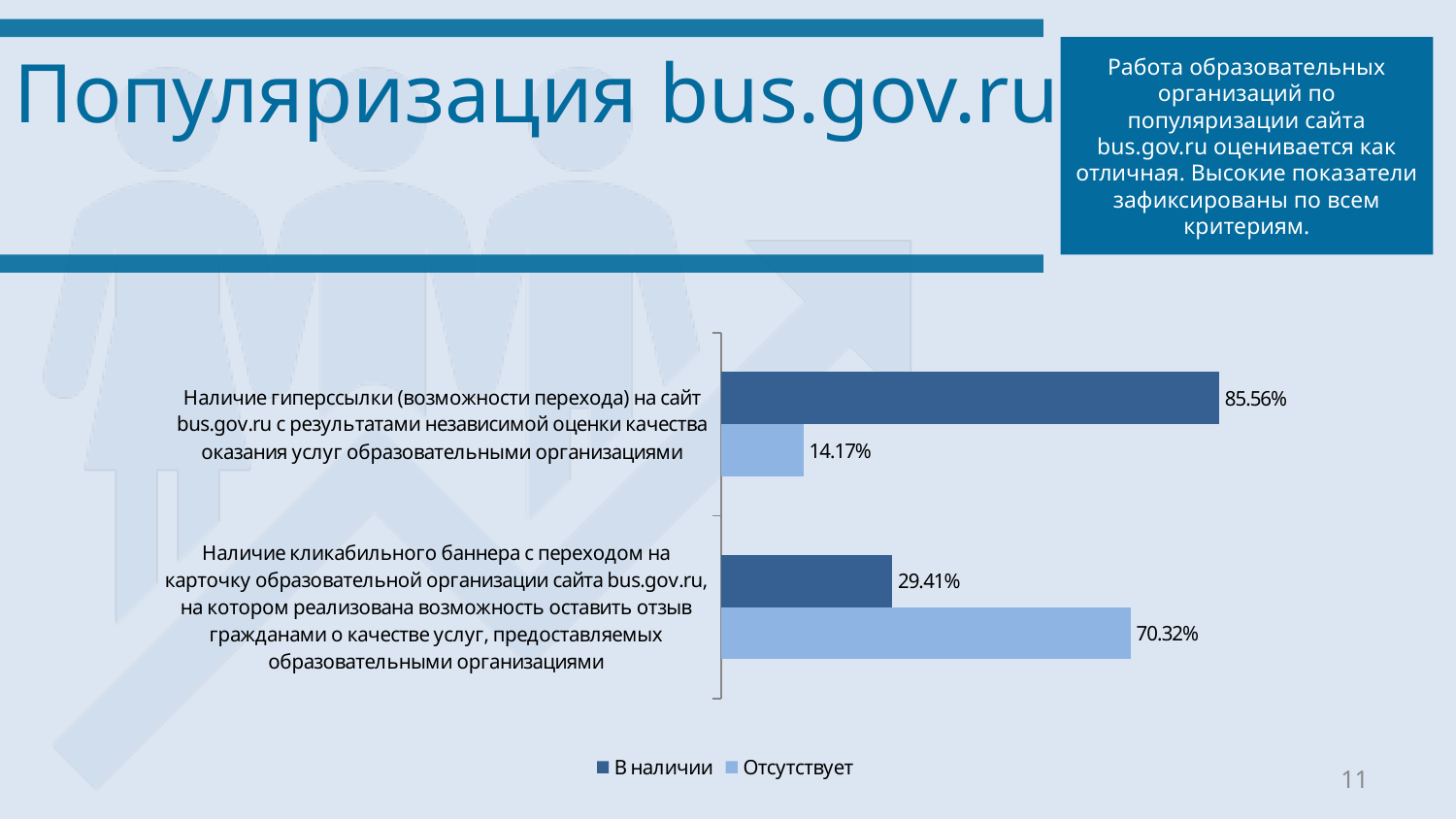
What is the value of "Отсутствует" for the category about the clickable banner (Наличие кликабильного баннера)? 70.32% What kind of chart is shown on the slide? bar chart What is the value of "Отсутствует" for the category about the hyperlink to bus.gov.ru (Наличие гиперссылки)? 14.17% What is the difference between the "В наличии" values for the hyperlink category and the clickable banner category? 56.15% For the clickable banner category, which is larger: "В наличии" or "Отсутствует"? Отсутствует Which category has the highest "В наличии" value? Наличие гиперссылки (возможности перехода) на сайт bus.gov.ru Which legend entry is shown in the darker blue colour? В наличии How many series does the chart legend list? 2 Which category has the lowest "Отсутствует" value? Наличие гиперссылки (возможности перехода) на сайт bus.gov.ru How many categories are plotted in the chart? 2 What is the value of "В наличии" for the category about the hyperlink to bus.gov.ru (Наличие гиперссылки)? 85.56% What is the value of "В наличии" for the category about the clickable banner (Наличие кликабильного баннера)? 29.41%